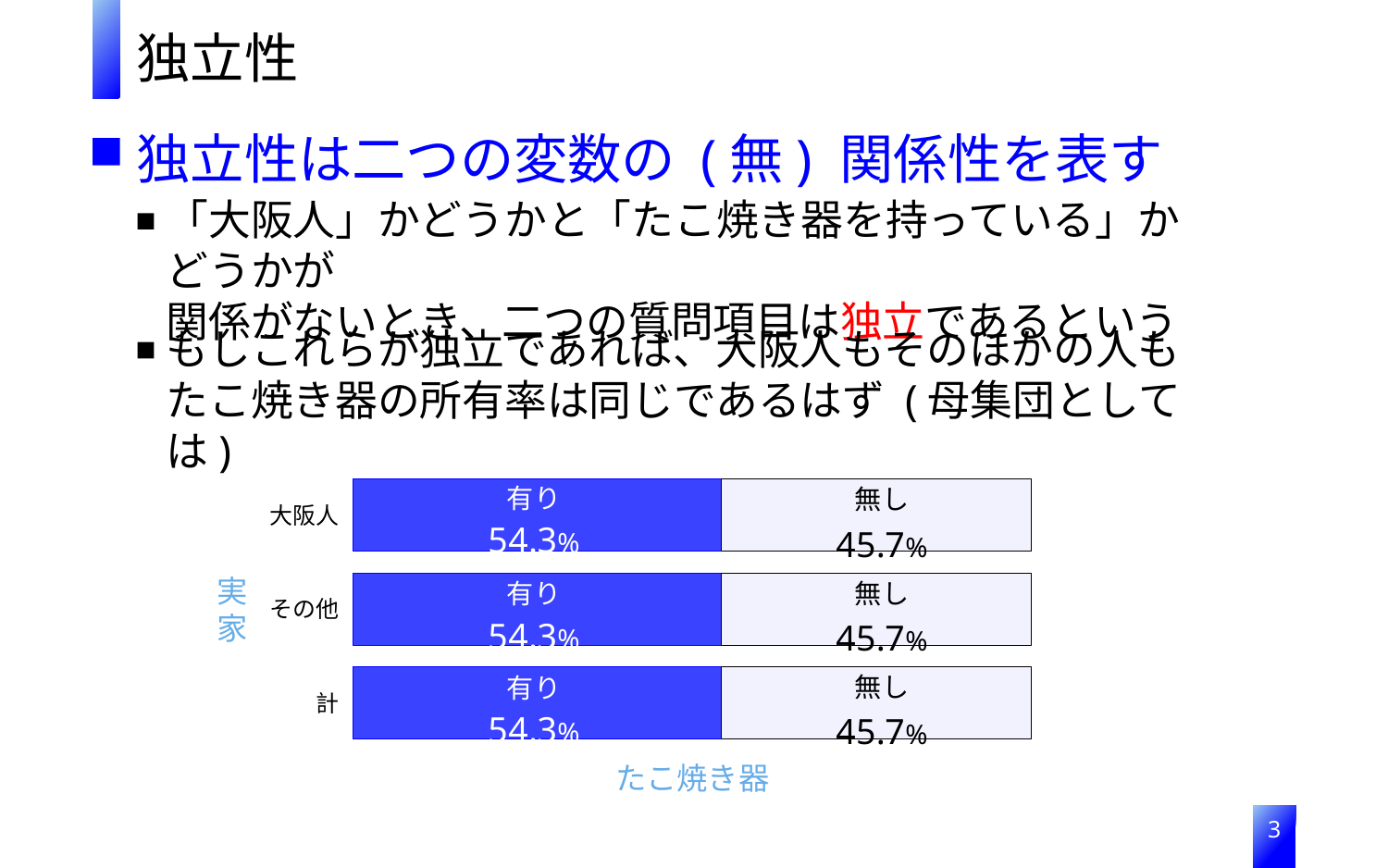
What is the difference between the 有り and 無し values for その他? 8.6% What label appears below the chart along the horizontal axis? たこ焼き器 How many categories (rows) does the chart show? 3 What is the 有り value for その他? 54.3% What is the total of the 大阪人 bar (有り plus 無し)? 100% What is the 無し value for 計? 45.7% Which is larger for 計, 有り or 無し? 有り What kind of chart is shown on the slide? stacked bar chart What is the 無し value for 大阪人? 45.7% Does the 有り share differ between 大阪人 and その他? No, both are 54.3% What is the 有り value for 大阪人? 54.3% What label appears to the left of the chart along the vertical axis? 実家